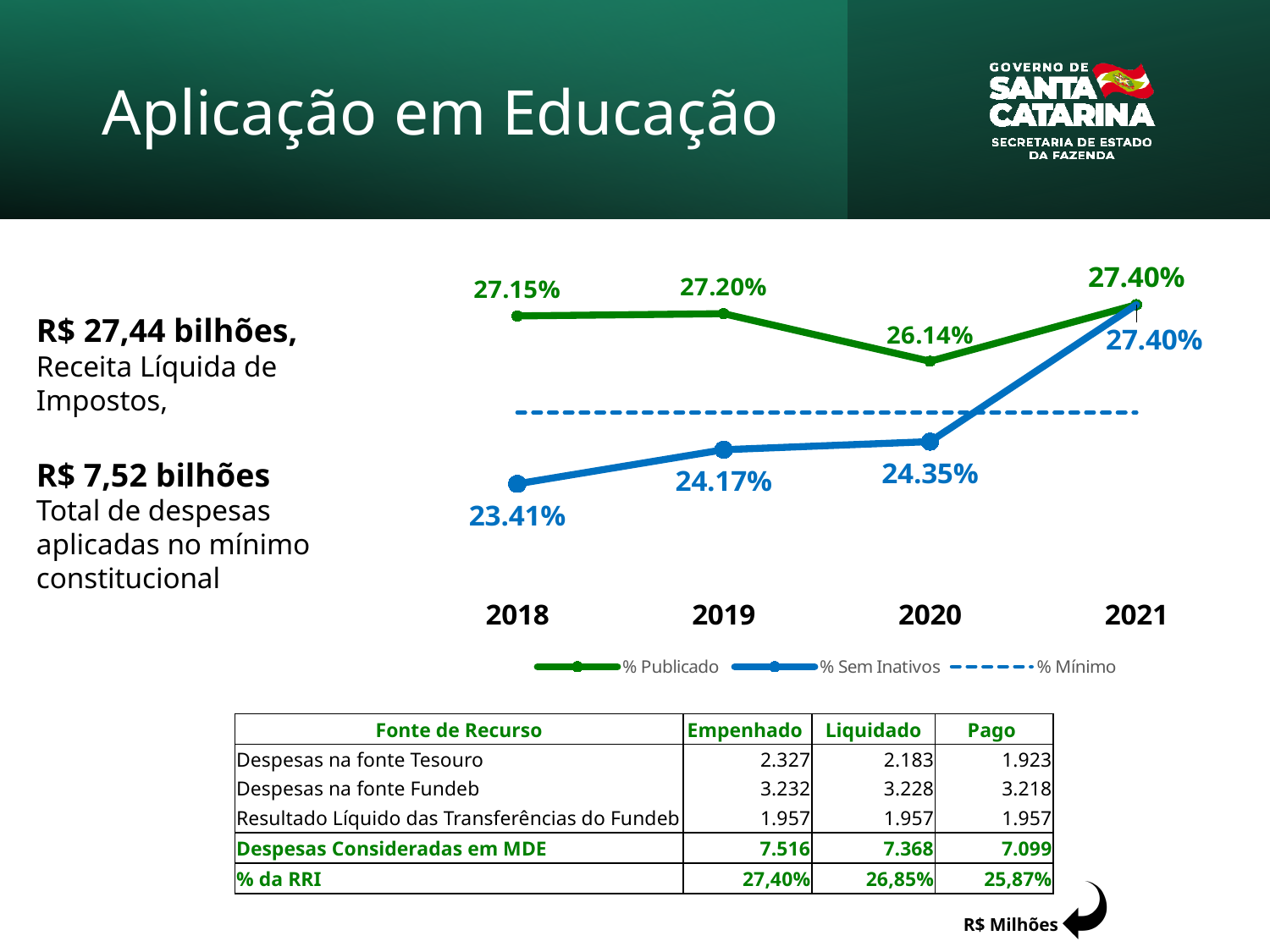
Which is larger in 2020, the % Publicado value or the % Sem Inativos value? % Publicado In which year is the % Publicado series highest? 2021 How many series does the chart legend list? 3 What is the % Sem Inativos value for 2021? 27.40% Does the % Sem Inativos series rise or fall from 2018 to 2021? Rise How many years are shown on the x axis of the chart? 4 What kind of chart is shown on the slide? Line chart In which year is the % Sem Inativos series lowest? 2018 What is the % Sem Inativos value for 2019? 24.17% What is the % Publicado value for 2020? 26.14% What is the difference between the % Publicado and % Sem Inativos values in 2018? 3.74% What is the % Publicado value for 2018? 27.15%